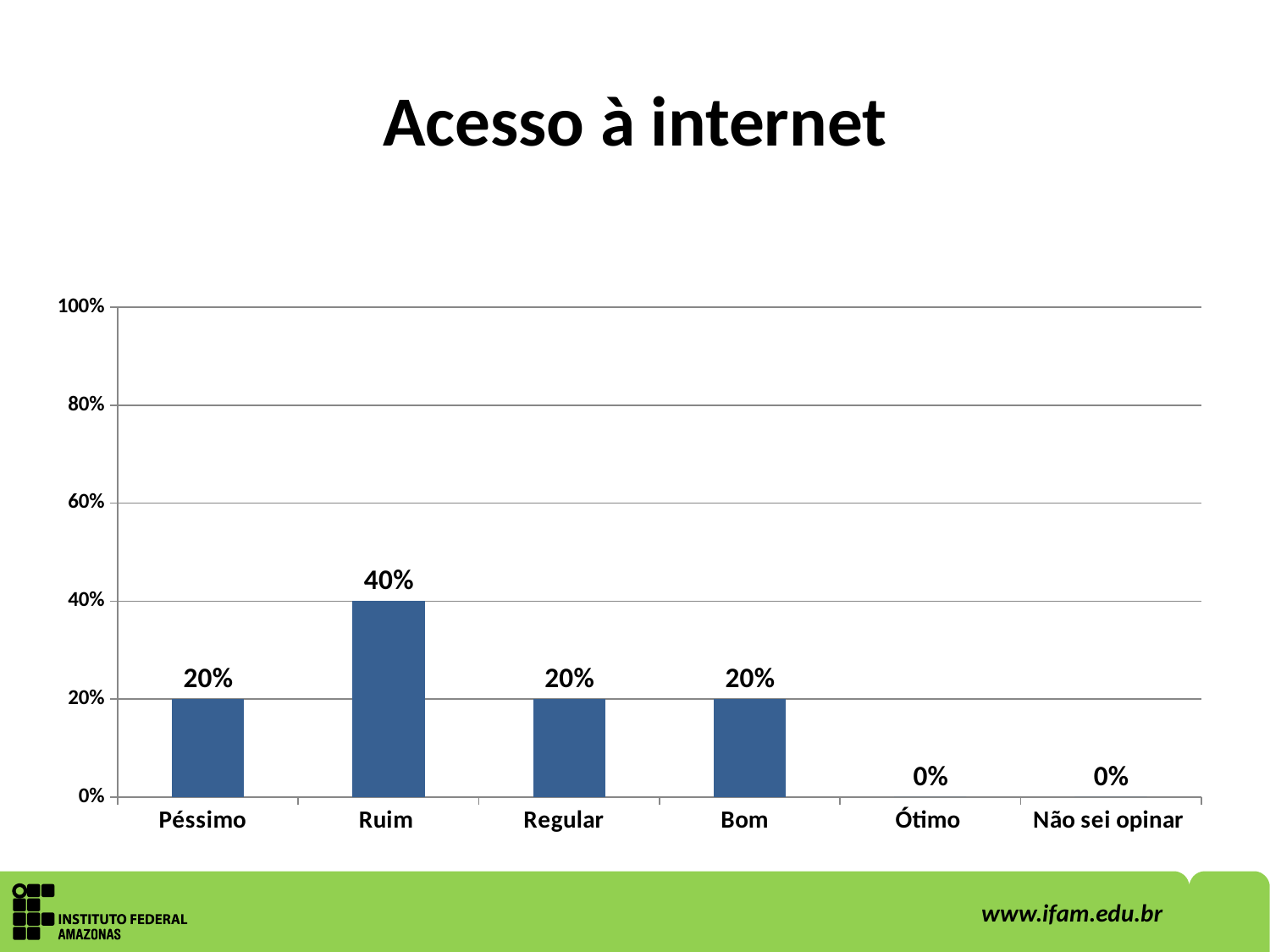
What is the difference between the values for Ruim and Regular? 20% Is the value for Ruim greater or less than 60%? less What is the title of the chart? Acesso à internet What is the value for Não sei opinar? 0% What kind of chart is shown on the slide? bar chart Which is larger, the value for Ruim or the value for Bom? Ruim What is the value for Ótimo? 0% How many categories have a value of 20%? 3 What is the value for Ruim? 40% How many categories are shown on the x axis? 6 What is the value for Péssimo? 20% Which category has the highest value? Ruim